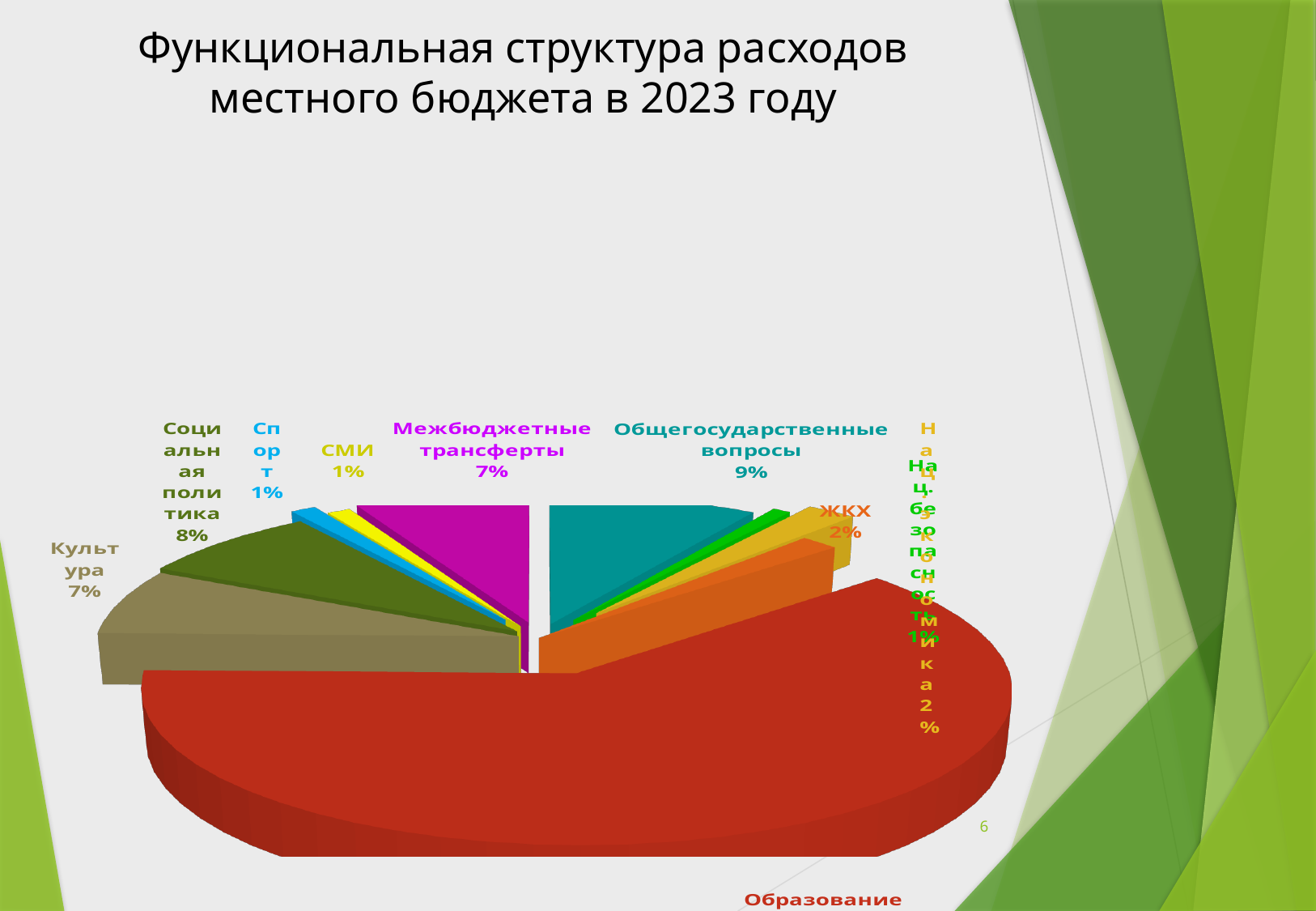
What is the title of the chart on the slide? Функциональная структура расходов местного бюджета в 2023 году Which is larger: the share for Культура or the share for СМИ? Культура What share of expenditures is labelled for Культура? 7% Which is larger: the share for Общегосударственные вопросы or the share for Социальная политика? Общегосударственные вопросы What kind of chart is shown on the slide? pie chart What share of expenditures is labelled for Социальная политика? 8% What share of expenditures is labelled for Межбюджетные трансферты? 7% What share of expenditures is labelled for Спорт? 1% What share of expenditures is labelled for ЖКХ? 2% What share of expenditures is labelled for Общегосударственные вопросы? 9% By how many percentage points does the share for Общегосударственные вопросы exceed the share for ЖКХ? 7 Which category has the largest slice of the pie? Образование